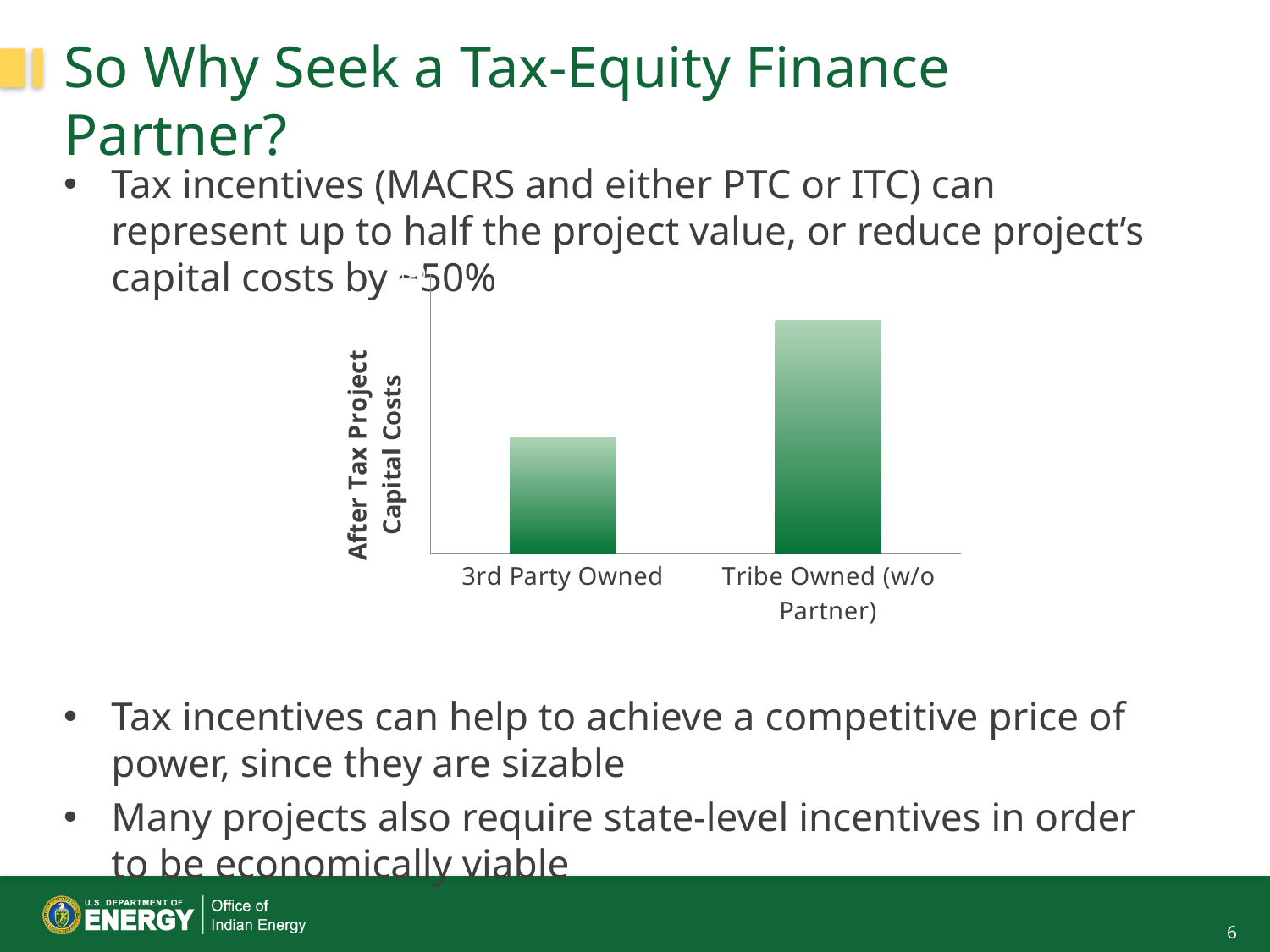
What are the two category labels on the x axis of the chart? 3rd Party Owned; Tribe Owned (w/o Partner) Do the bar values rise or fall moving from left to right along the x axis? rise What is the label on the vertical axis of the chart? After Tax Project Capital Costs What kind of chart is shown on the slide? bar chart Which is larger in the chart: the bar for 3rd Party Owned or the bar for Tribe Owned (w/o Partner)? Tribe Owned (w/o Partner) Which category has the highest after-tax project capital costs in the chart? Tribe Owned (w/o Partner) Which category has the lowest after-tax project capital costs in the chart? 3rd Party Owned How many categories are plotted in the chart? 2